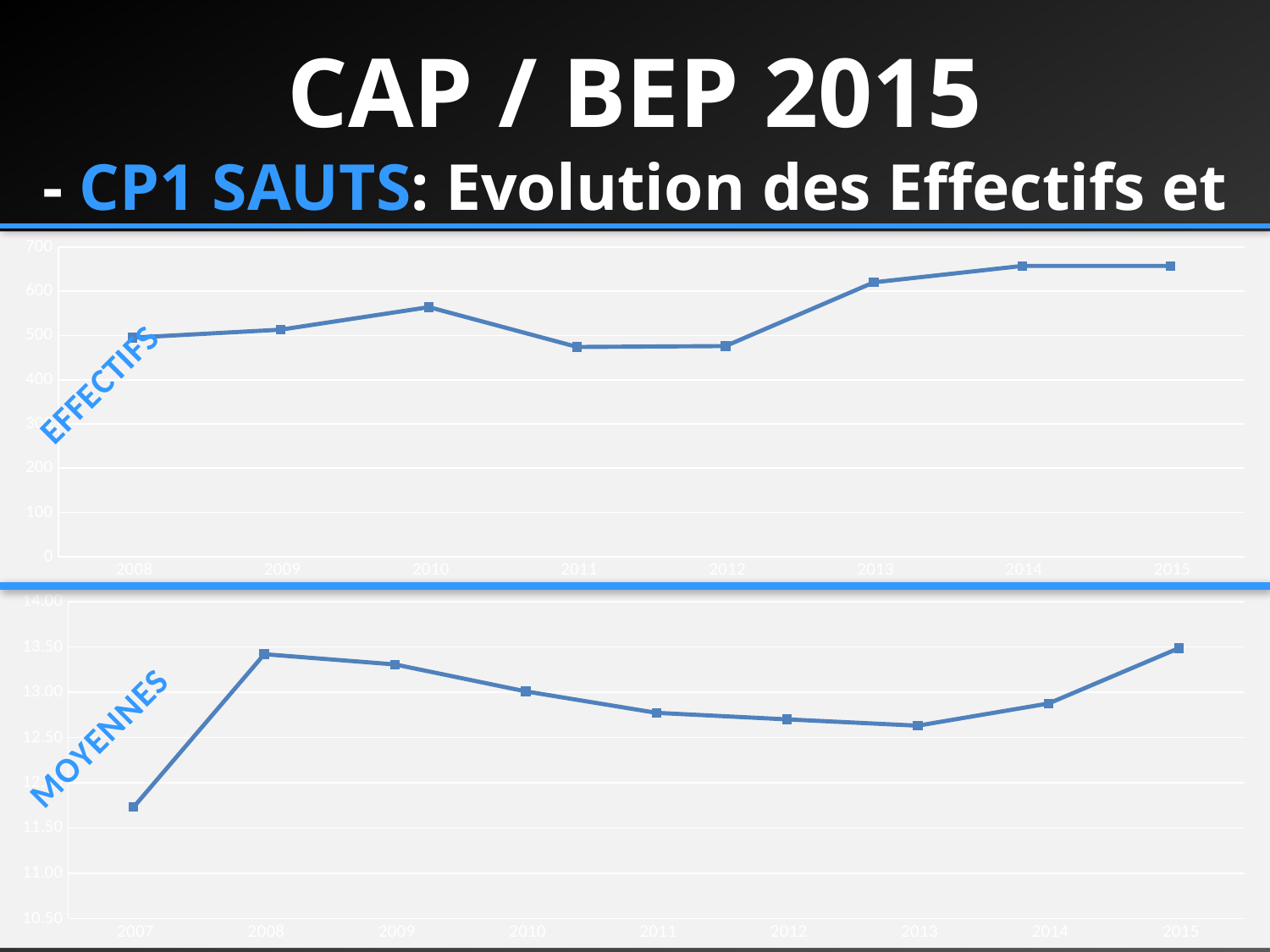
How many years are plotted on the bottom chart labelled MOYENNES? 9 On the bottom chart labelled MOYENNES, which year has the lowest value? 2007 On the bottom chart labelled MOYENNES, is the value for 2007 greater or less than 12.00? less What kind of chart is the top chart labelled EFFECTIFS? line chart On the top chart labelled EFFECTIFS, is the value for 2011 greater or less than 500? less What is the label written on the bottom chart? MOYENNES On the bottom chart labelled MOYENNES, do the values rise or fall from 2013 to 2015? rise How many years are plotted on the top chart labelled EFFECTIFS? 8 On the top chart labelled EFFECTIFS, which year has the larger value, 2011 or 2013? 2013 On the top chart labelled EFFECTIFS, is the value for 2010 greater or less than 500? greater